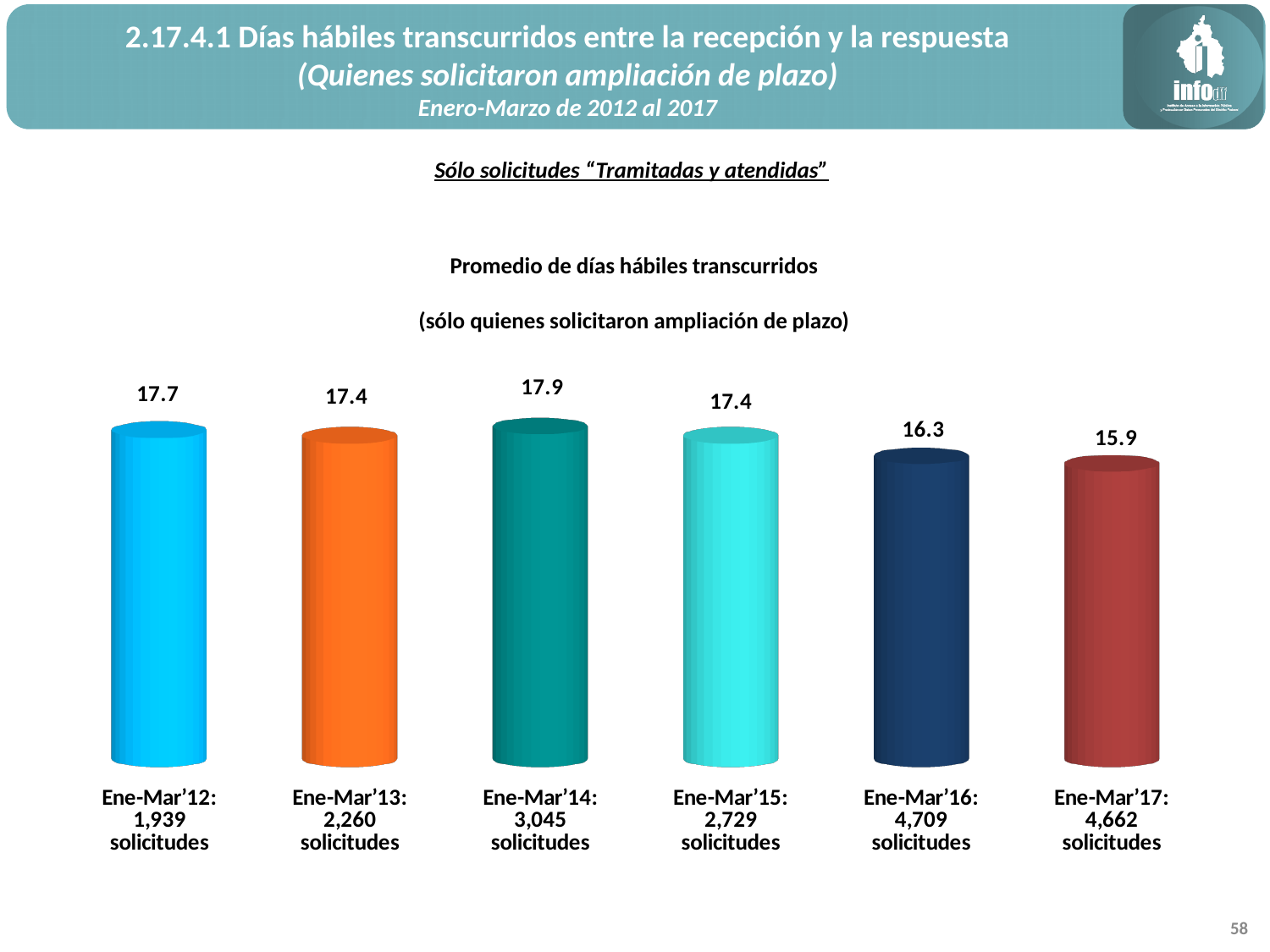
What kind of chart is shown on the slide? Bar chart What is the average number of business days for Ene-Mar'12? 17.7 Which is larger, the value for Ene-Mar'12 or the value for Ene-Mar'15? Ene-Mar'12 Which period has the highest average number of business days? Ene-Mar'14 What is the difference between the values for Ene-Mar'14 and Ene-Mar'17? 2.0 What is the value shown for Ene-Mar'17? 15.9 Do the values generally rise or fall from Ene-Mar'14 to Ene-Mar'17? Fall What is the value shown for Ene-Mar'16? 16.3 Which period has the lowest average number of business days? Ene-Mar'17 How many solicitudes are indicated for Ene-Mar'16 in the category label? 4,709 solicitudes How many periods (bars) are shown in the chart? 6 What is the difference between the values for Ene-Mar'12 and Ene-Mar'16? 1.4